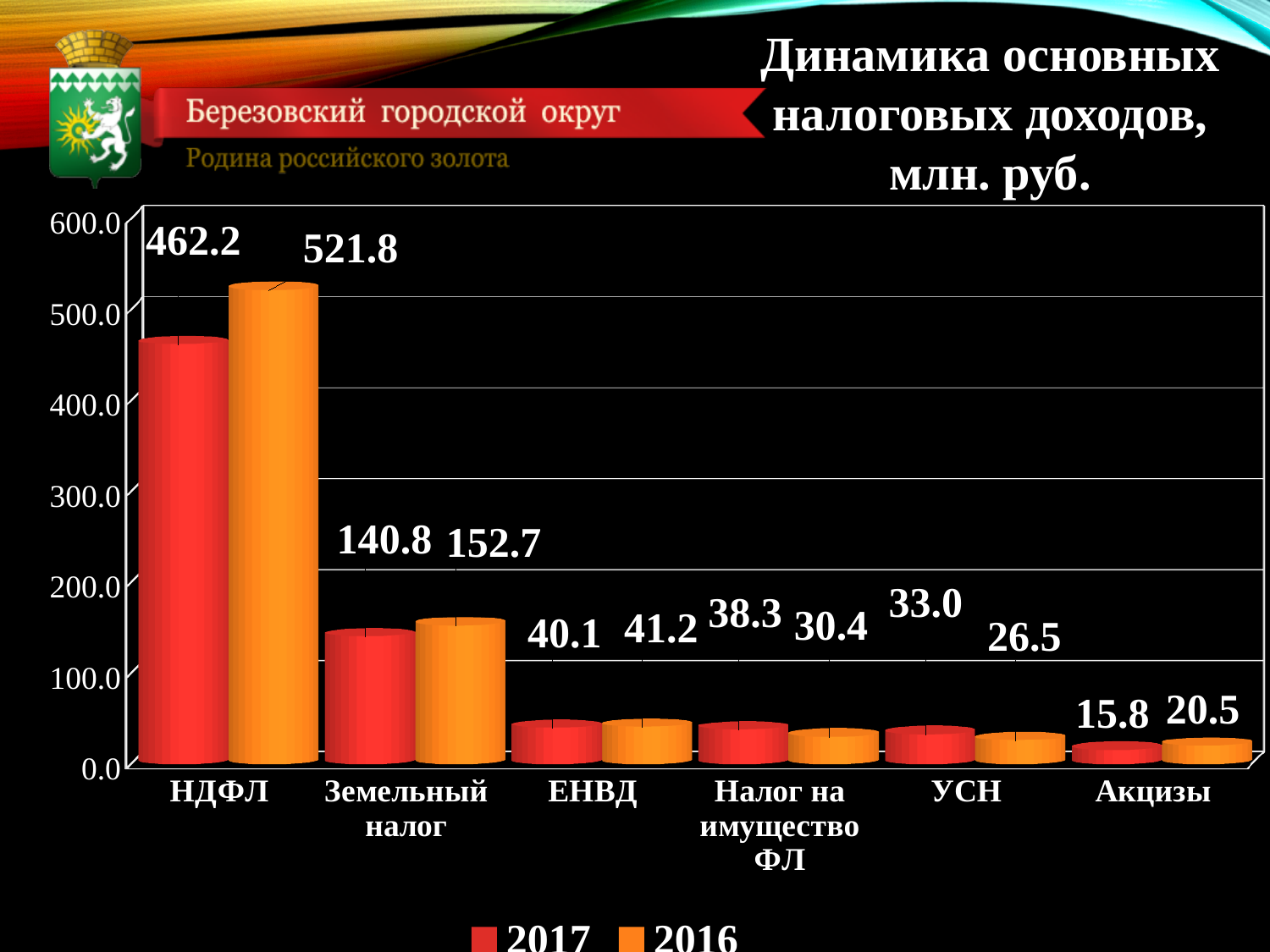
Which category has the lowest 2017 value? Акцизы What is the 2016 value for Акцизы? 20.5 What is the 2016 value for Земельный налог? 152.7 What kind of chart is shown on the slide? Bar chart How many categories are shown on the x axis? 6 What is the 2017 value for УСН? 33.0 What is the 2017 value for НДФЛ? 462.2 What is the title of the chart? Динамика основных налоговых доходов, млн. руб. Which category has the highest 2016 value? НДФЛ How many series does the legend list? 2 What is the difference between the 2016 and 2017 values for НДФЛ? 59.6 Which is larger for Налог на имущество ФЛ, the 2017 value or the 2016 value? 2017